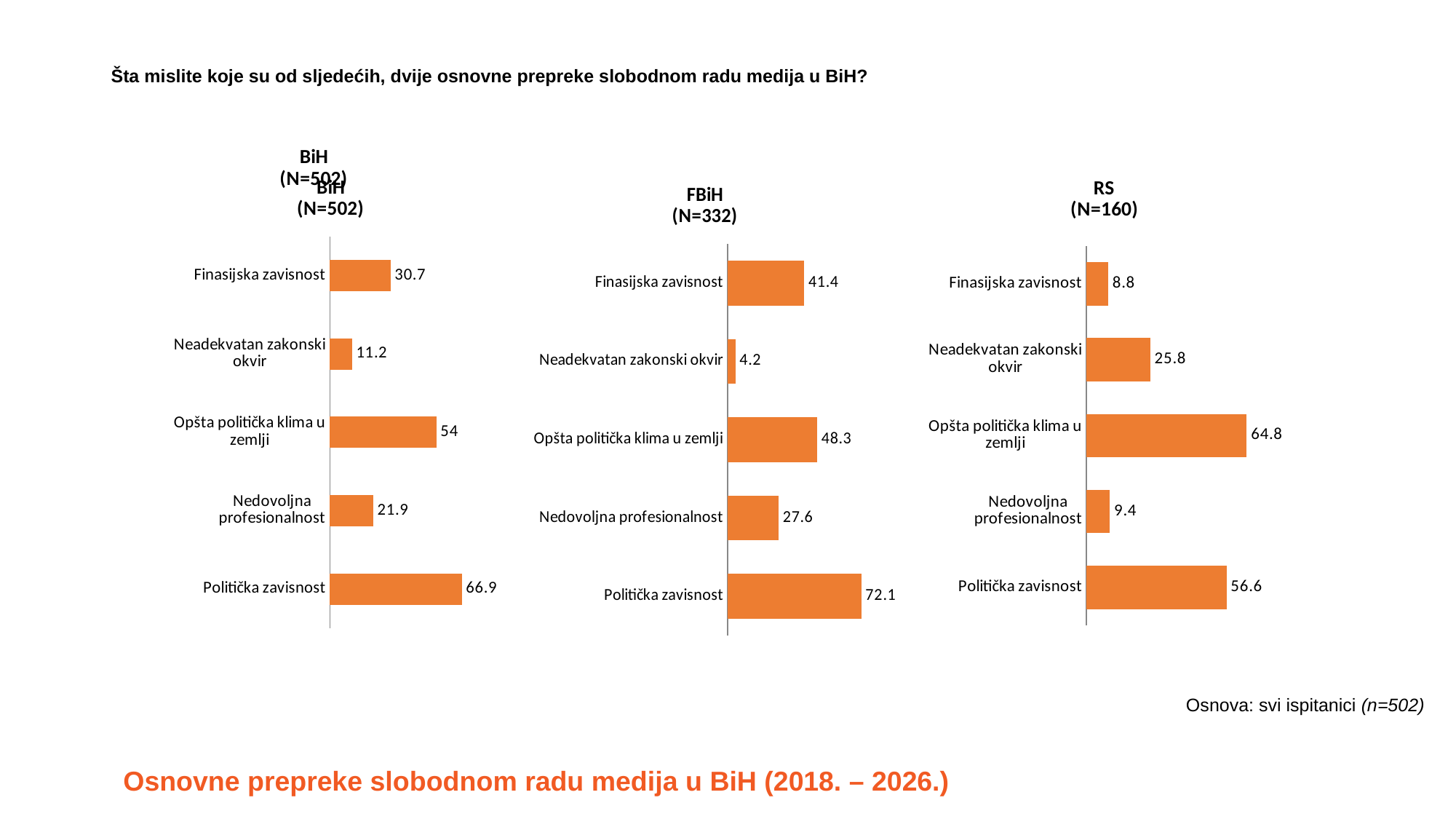
In the FBiH (N=332) chart, what is the value for Neadekvatan zakonski okvir? 4.2 In the BiH (N=502) chart, what is the difference between Politička zavisnost and Opšta politička klima u zemlji? 12.9 In the FBiH (N=332) chart, which category has the lowest value? Neadekvatan zakonski okvir In the BiH (N=502) chart, what is the value for Politička zavisnost? 66.9 How many charts are shown on the slide? 3 In the RS (N=160) chart, what is the value for Opšta politička klima u zemlji? 64.8 In the FBiH (N=332) chart, what is the difference between Politička zavisnost and Finasijska zavisnost? 30.7 In the RS (N=160) chart, which category has the highest value? Opšta politička klima u zemlji In the RS (N=160) chart, which is larger: Neadekvatan zakonski okvir or Nedovoljna profesionalnost? Neadekvatan zakonski okvir What type of chart is the RS (N=160) chart? Bar chart In the BiH (N=502) chart, which category has the highest value? Politička zavisnost How many categories are shown in the FBiH (N=332) chart? 5